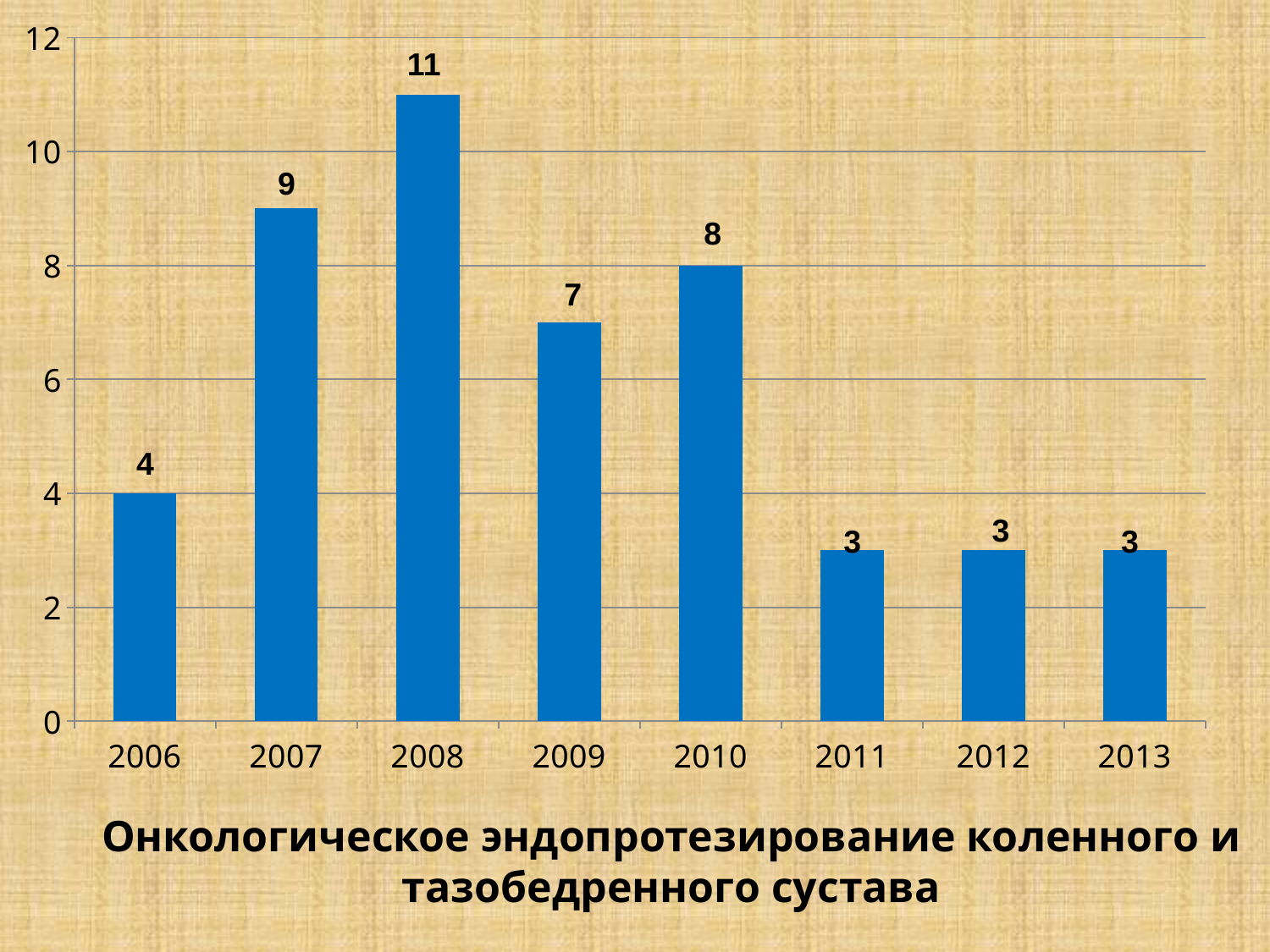
What kind of chart is shown on the slide? bar chart What is the value for 2008? 11 What is the value for 2006? 4 What is the difference between the values for 2008 and 2009? 4 Which year has the highest value? 2008 What is the value for 2010? 8 Which is larger, the value for 2009 or the value for 2010? 2010 How many years are shown on the x axis? 8 What is the title of the chart? Онкологическое эндопротезирование коленного и тазобедренного сустава Do the values rise or fall from 2010 to 2011? fall What is the difference between the values for 2007 and 2006? 5 Is the value for 2007 greater or less than 8? greater